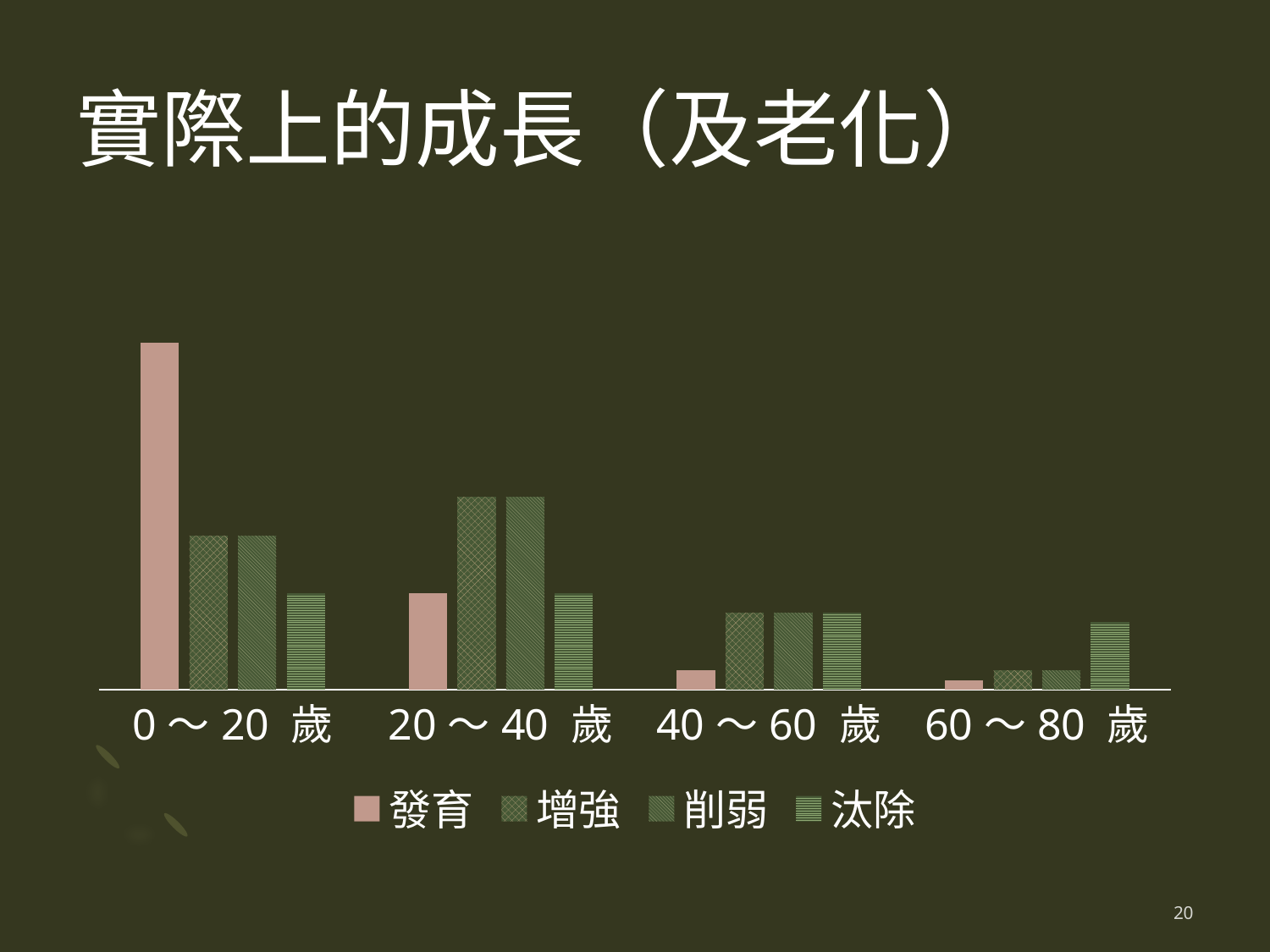
In the 60～80 歲 category, which series has the highest bar? 汰除 What kind of chart is shown on the slide? bar chart Does the value for 發育 rise or fall as age increases along the x axis? fall Which age category has the highest value for 發育? 0～20 歲 How many age categories are shown on the x axis of the chart? 4 Which age category has the lowest value for 發育? 60～80 歲 What is the title of the slide containing the chart? 實際上的成長（及老化） In the 0～20 歲 category, which series has the highest bar? 發育 Which series is shown in the solid pink colour in the chart? 發育 In the 20～40 歲 category, which is larger, 發育 or 增強? 增強 How many series does the chart's legend list? 4